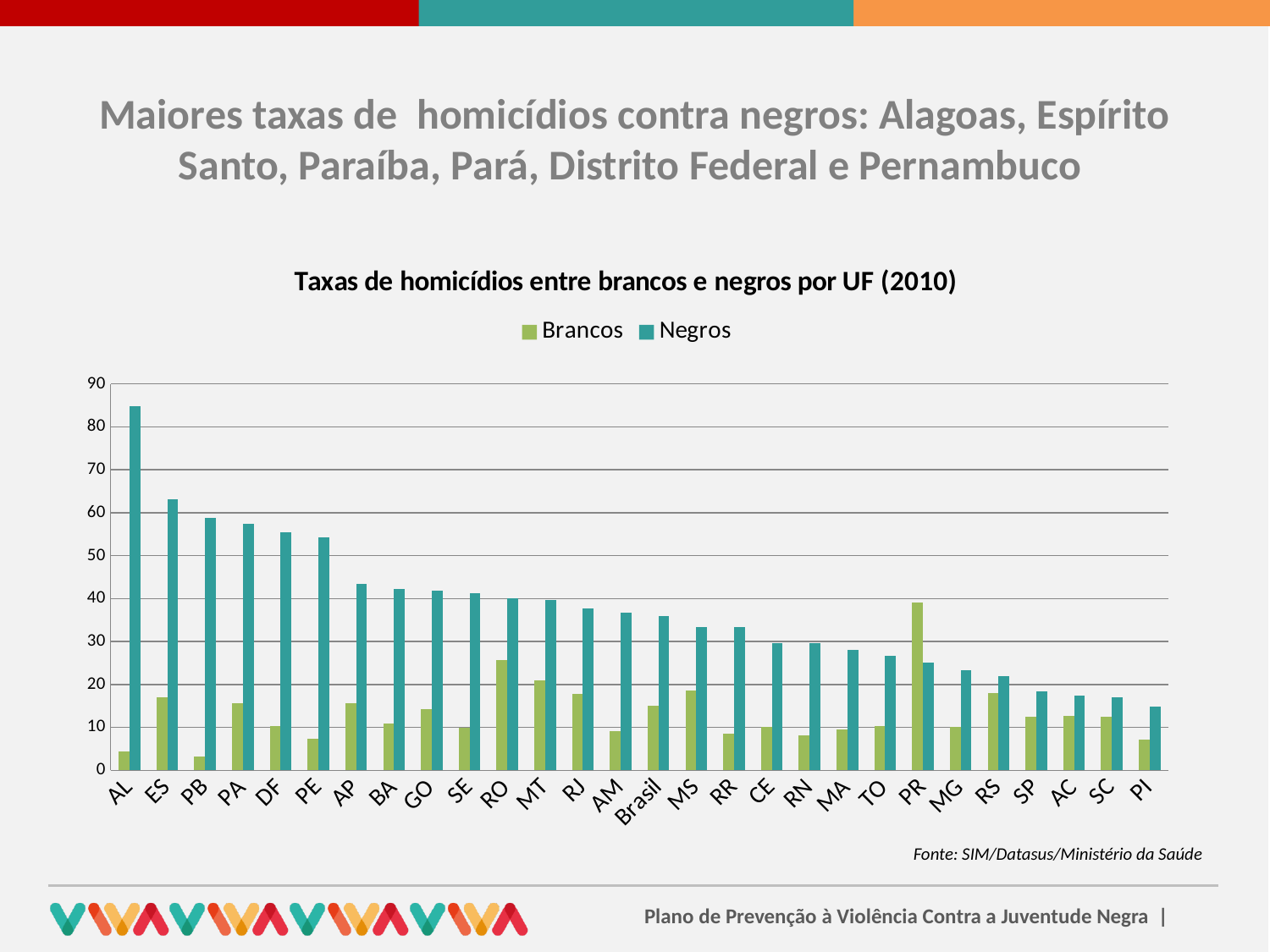
Is the Negros value for PI greater or less than 20? less Which category has the highest value for Brancos? PR For PR, which is larger: the Brancos value or the Negros value? Brancos Do the Negros values generally rise or fall from left to right along the x axis? fall How many categories (UFs plus Brasil) are shown on the x axis? 28 Is the Brancos value for PR greater or less than 30? greater Which category has the lowest value for Negros? PI What kind of chart is shown on the slide? bar chart Is the Negros value for AL greater or less than 80? greater How many series does the legend list? 2 Which category has the highest value for Negros? AL What are the two series named in the legend? Brancos and Negros